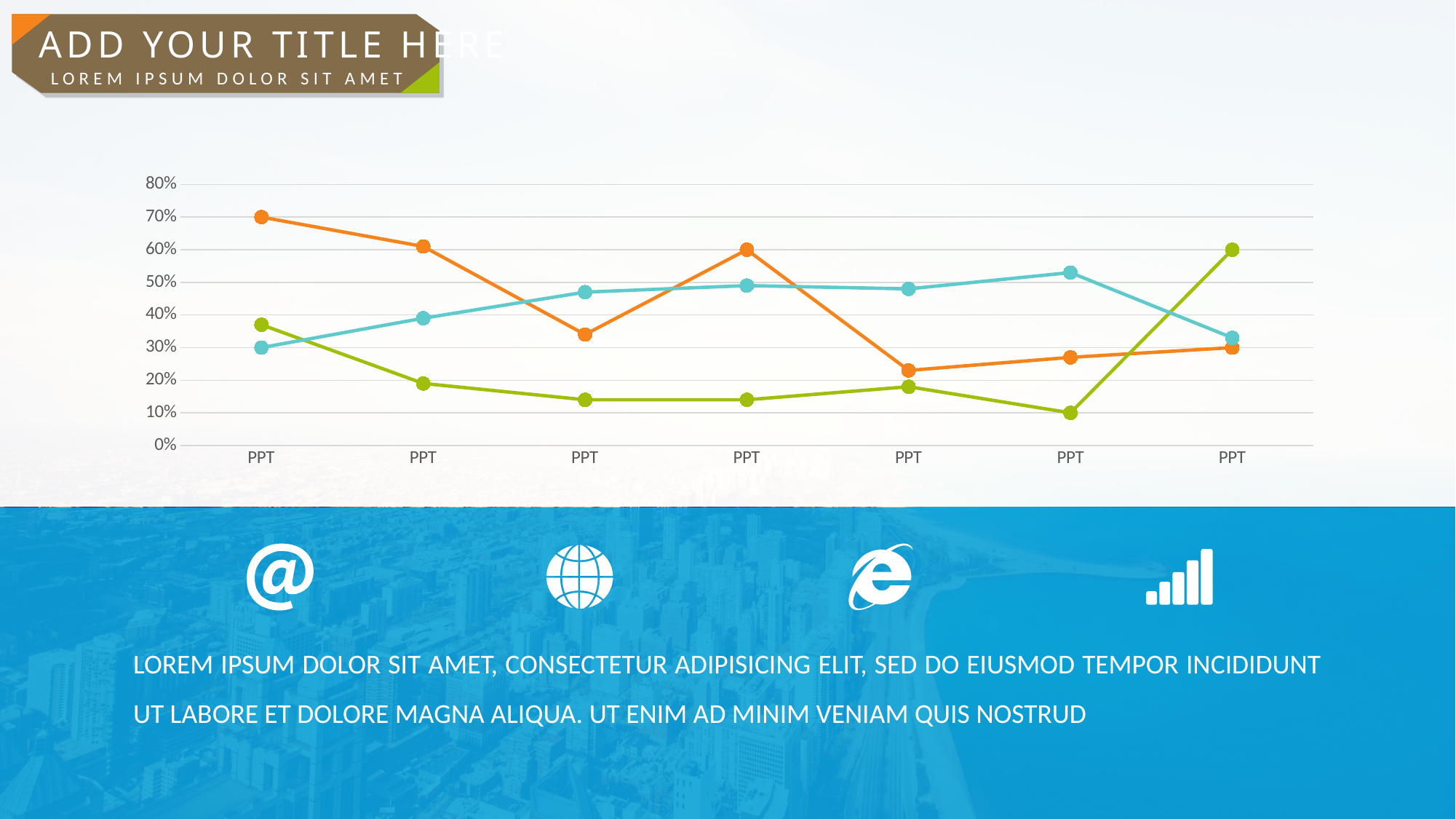
At the first category, which is larger: the orange line or the green line? the orange line What kind of chart is shown on the slide? line chart Is the value of the orange line at the fifth category greater or less than 30%? less Is the value of the teal line at the fourth category greater or less than 40%? greater Which line has the highest single point on the chart? the orange line How many lines are plotted on the chart? 3 How many data points does each line have along the x axis? 7 What is the value of the orange line at the first category? 70% Does the orange line rise or fall from the first category to the third category? fall Which line has the lowest single point on the chart? the green line What is the value of the green line at the last (seventh) category? 60% Is the value of the green line at the third category greater or less than 20%? less